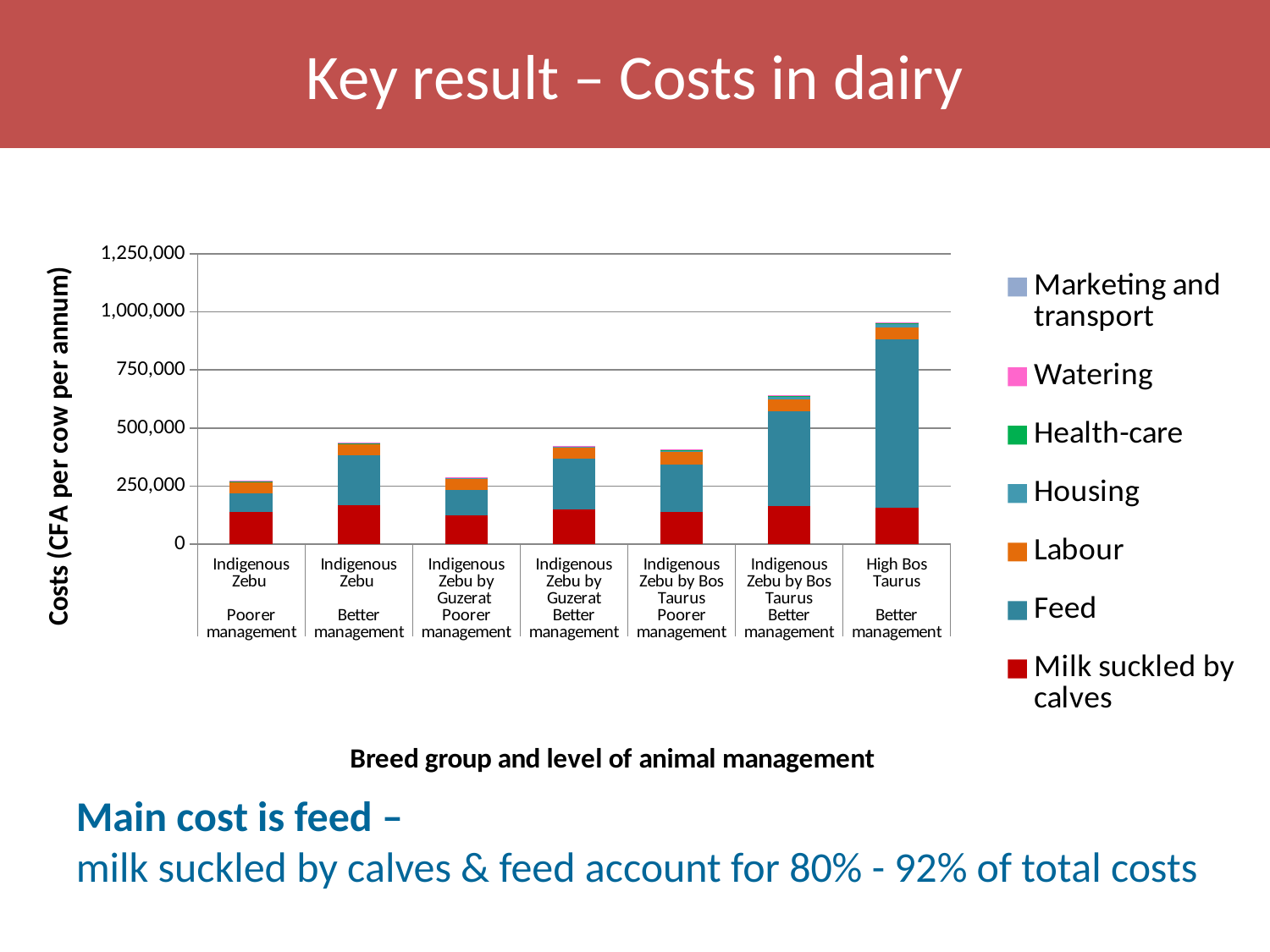
How many series does the legend list? 7 How many breed group and management categories are shown on the x axis? 7 Which category has the highest total cost? High Bos Taurus, Better management What kind of chart is shown on the slide? Stacked bar chart Is the total cost for High Bos Taurus under Better management greater or less than 750,000? greater Is the total cost for Indigenous Zebu by Bos Taurus under Better management greater or less than 500,000? greater What is the title of the y axis? Costs (CFA per cow per annum) What is the title of the x axis? Breed group and level of animal management Which has the larger total cost: High Bos Taurus under Better management or Indigenous Zebu under Better management? High Bos Taurus under Better management Which has the larger total cost: Indigenous Zebu by Bos Taurus under Better management or Indigenous Zebu by Bos Taurus under Poorer management? Indigenous Zebu by Bos Taurus under Better management Is the total cost for Indigenous Zebu under Poorer management greater or less than 500,000? less